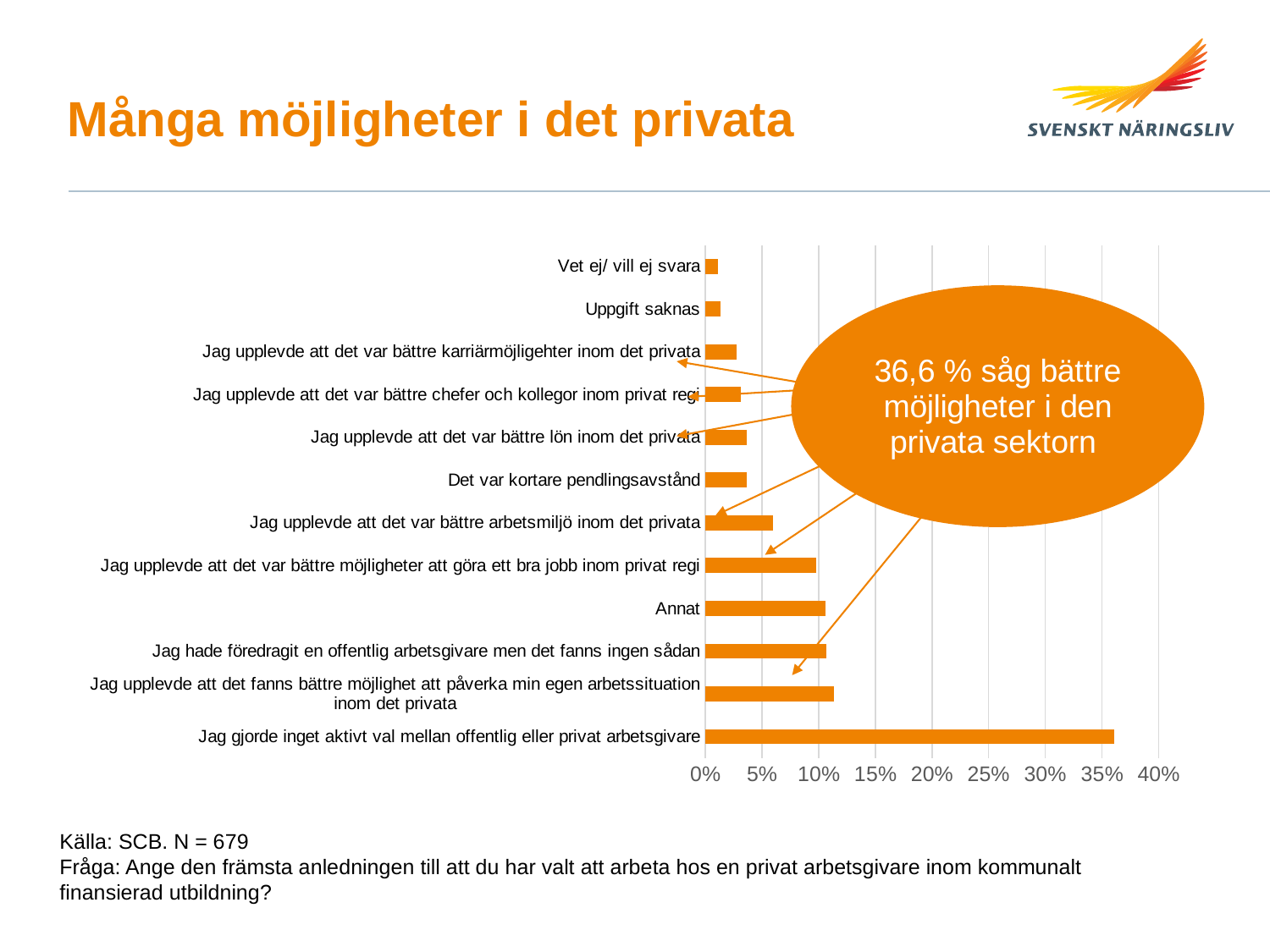
Is the value for "Jag gjorde inget aktivt val mellan offentlig eller privat arbetsgivare" greater or less than 30%? greater How many categories (bars) does the chart show? 12 Is the value for "Jag upplevde att det var bättre karriärmöjligehter inom det privata" greater or less than 5%? less Is the value for "Jag upplevde att det var bättre arbetsmiljö inom det privata" greater or less than 10%? less Which category has the highest value in the chart? Jag gjorde inget aktivt val mellan offentlig eller privat arbetsgivare Which is larger: the value for "Jag upplevde att det var bättre arbetsmiljö inom det privata" or the value for "Jag upplevde att det var bättre lön inom det privata"? Jag upplevde att det var bättre arbetsmiljö inom det privata What is the title of the slide containing the chart? Många möjligheter i det privata What kind of chart is shown on the slide? Bar chart What percentage does the orange callout on the chart say saw better opportunities in the private sector? 36,6 % Which is larger: the value for "Annat" or the value for "Jag gjorde inget aktivt val mellan offentlig eller privat arbetsgivare"? Jag gjorde inget aktivt val mellan offentlig eller privat arbetsgivare Which is larger: the value for "Uppgift saknas" or the value for "Jag upplevde att det var bättre möjligheter att göra ett bra jobb inom privat regi"? Jag upplevde att det var bättre möjligheter att göra ett bra jobb inom privat regi